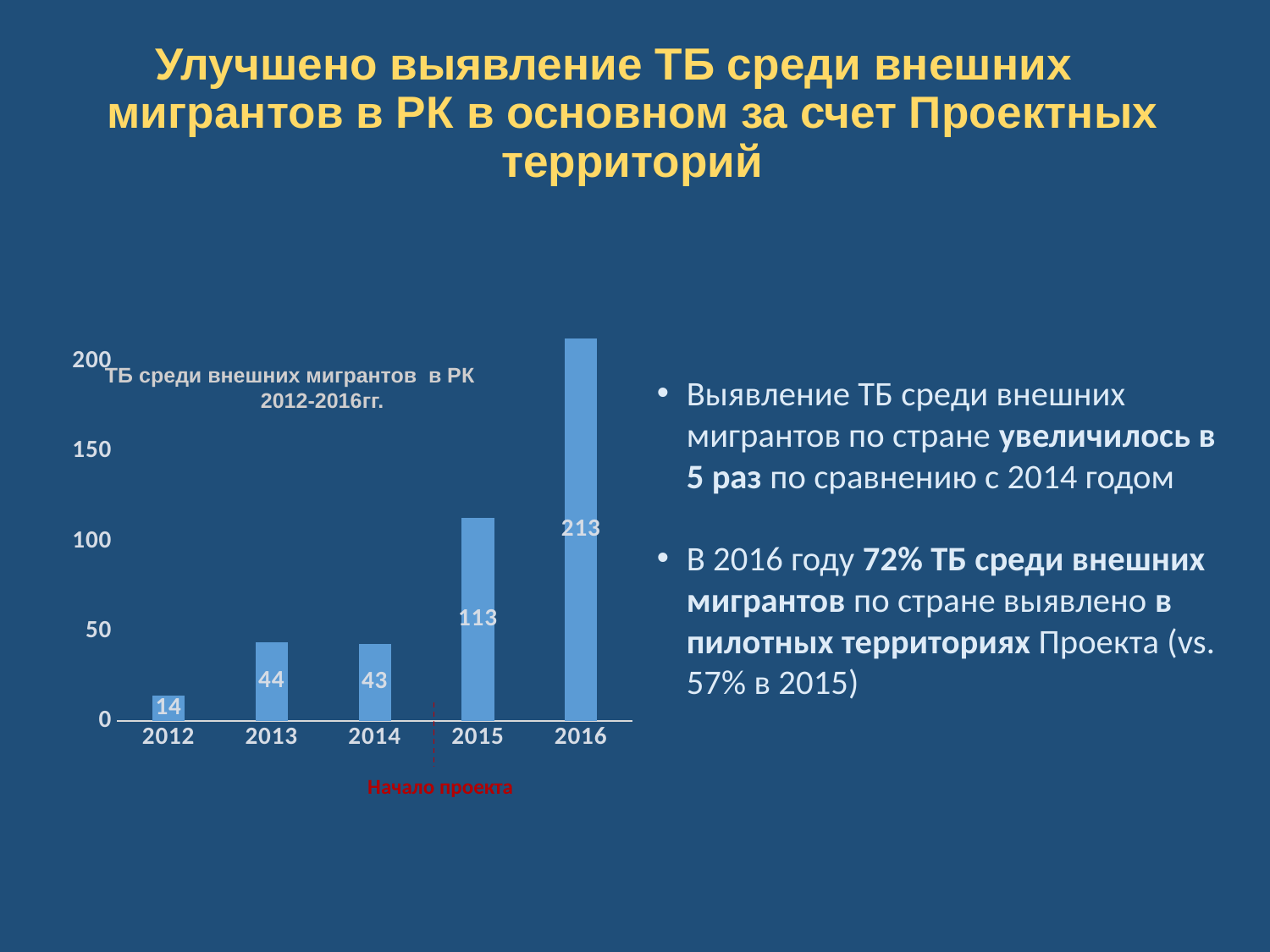
What is the title of the chart? ТБ среди внешних мигрантов в РК 2012-2016гг. What is the value for 2015? 113 What is the value for 2016? 213 How many years are shown on the x axis? 5 What type of chart is shown on the slide? bar chart What is the difference between the values for 2015 and 2014? 70 Which is larger, the value for 2015 or the value for 2014? 2015 What is the difference between the values for 2016 and 2015? 100 What is the value for 2012? 14 Which year has the lowest value? 2012 What is the value for 2013? 44 Which year has the highest value? 2016